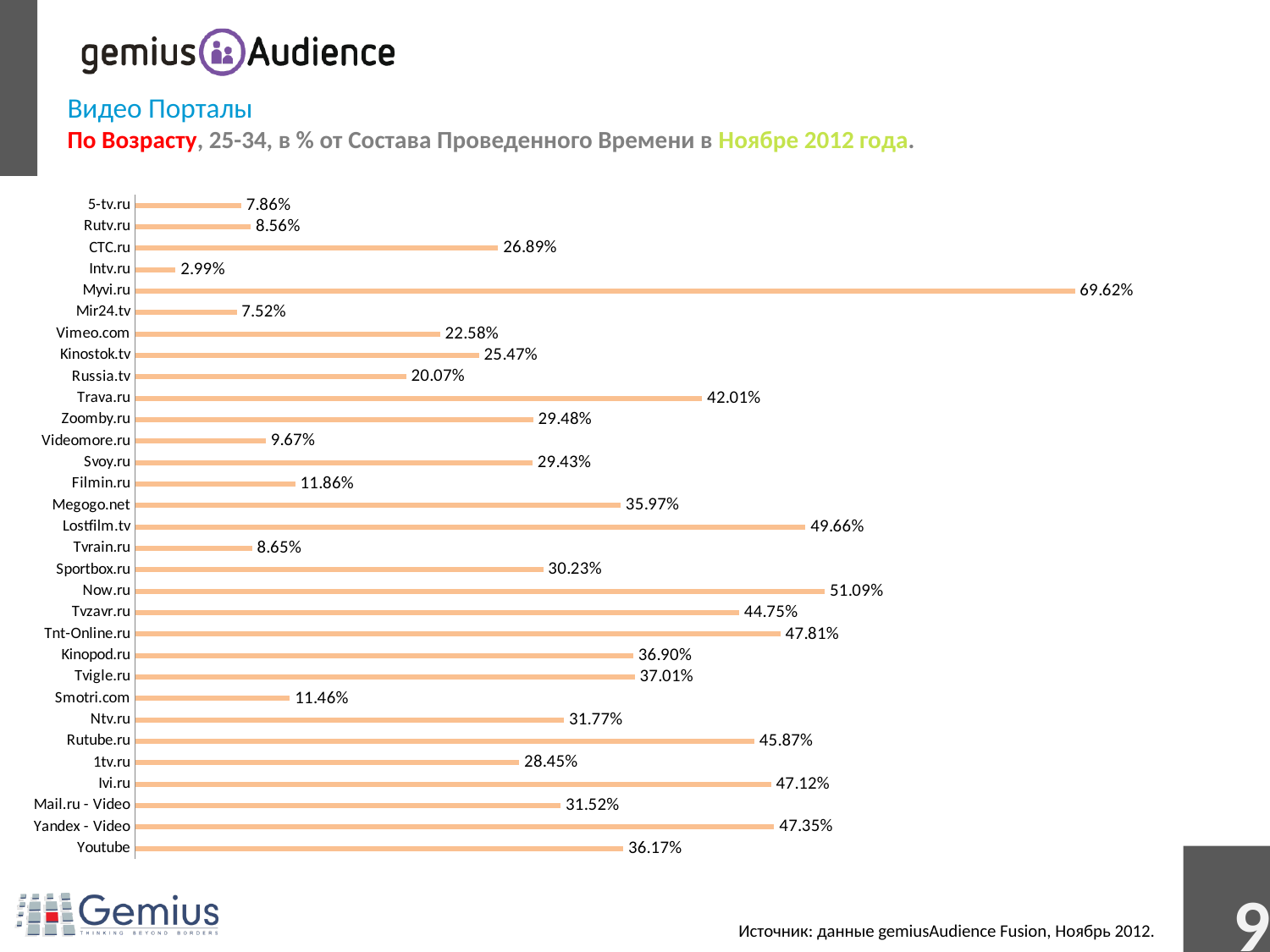
What is the difference between the values for Now.ru and Lostfilm.tv? 1.43% Which portal has the lowest value? Intv.ru Which has a larger value, Rutube.ru or Ivi.ru? Ivi.ru What is the value for Myvi.ru? 69.62% Which portal has the highest value? Myvi.ru What is the value for Mail.ru - Video? 31.52% Which has a larger value, Vimeo.com or Kinostok.tv? Kinostok.tv What is the difference between the values for Trava.ru and Sportbox.ru? 11.78% How many portals are shown in the chart? 31 What kind of chart is shown on the slide? Bar chart What is the value for Lostfilm.tv? 49.66% What is the value for Youtube? 36.17%